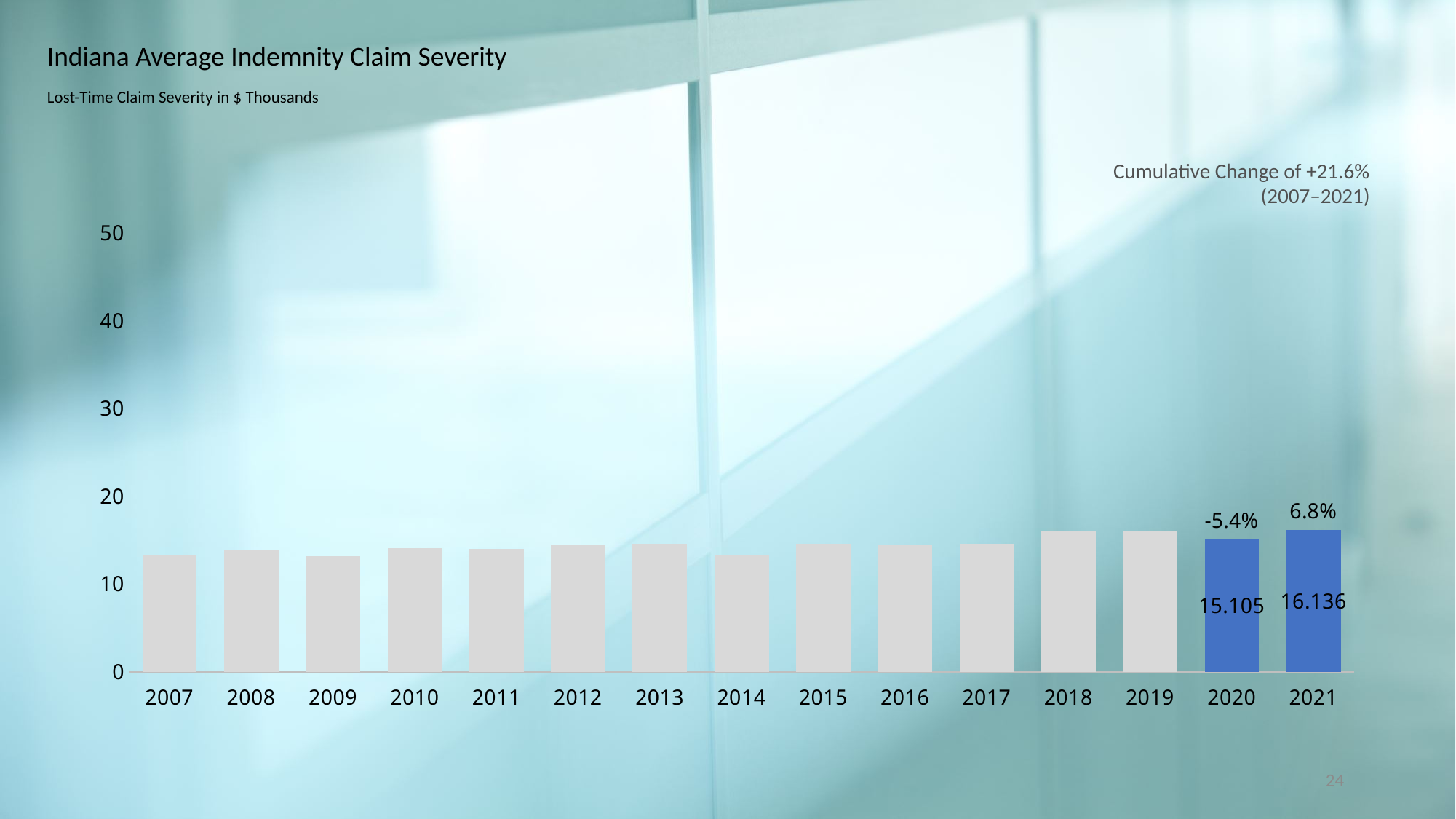
What is the value for 2020? 15.105 Do the values overall rise or fall from 2007 to 2021? rise What percentage change is labeled above the 2020 bar? -5.4% How many years are shown on the x axis? 15 What cumulative change from 2007 to 2021 is stated on the slide? +21.6% Which is larger, the value for 2020 or the value for 2021? 2021 What is the value for 2021? 16.136 Is the value for 2007 greater or less than 20? less What kind of chart is shown on the slide? Bar chart Is the value for 2018 greater or less than 10? greater What is the difference between the 2021 and 2020 values? 1.031